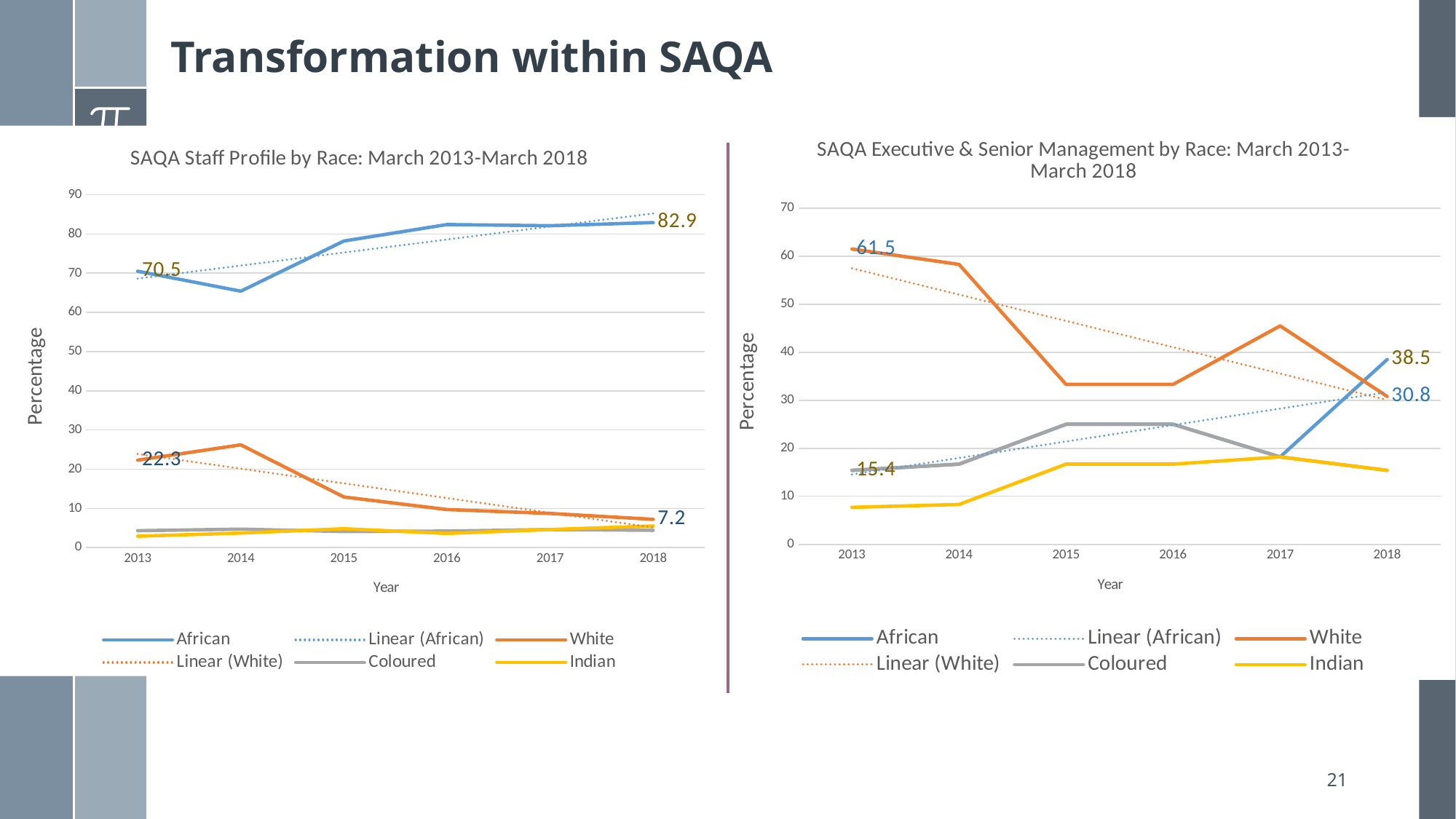
In the SAQA Executive & Senior Management by Race chart, what is the difference between the White values in 2013 and 2018? 30.7 What type of chart is the SAQA Executive & Senior Management by Race chart? line chart In the SAQA Staff Profile by Race chart, by how much did the African value change from 2013 to 2018? 12.4 In the SAQA Staff Profile by Race chart, is the value for African in 2014 greater or less than 70? less In the SAQA Staff Profile by Race chart, does the White line rise or fall from 2014 to 2018? fall In the SAQA Staff Profile by Race chart, what is the value for African in 2018? 82.9 In the SAQA Executive & Senior Management by Race chart, what is the value for African in 2018? 38.5 In the SAQA Staff Profile by Race chart, what is the value for White in 2013? 22.3 In the SAQA Executive & Senior Management by Race chart, which is larger in 2018, African or White? African In the SAQA Staff Profile by Race chart, how many years are shown on the x axis? 6 In the SAQA Executive & Senior Management by Race chart, is the value for Coloured in 2015 greater or less than 20? greater In the SAQA Executive & Senior Management by Race chart, what is the value for White in 2013? 61.5